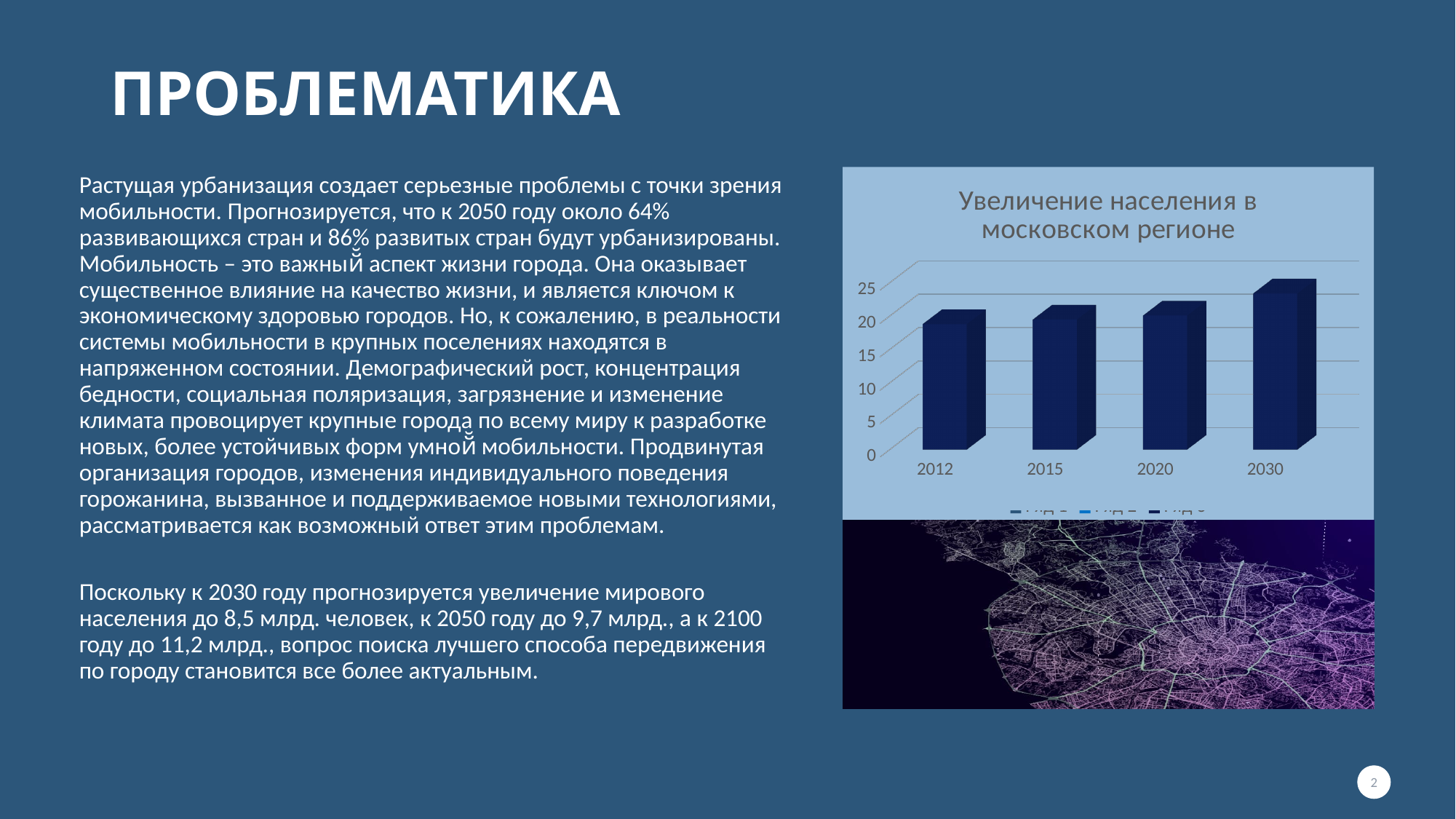
Do the values generally rise or fall from 2012 to 2030? rise How many categories (years) are shown on the x axis of the chart? 4 Is the value for 2030 greater or less than 20? greater Which year has the highest bar in the chart? 2030 Is the value for 2020 greater or less than 25? less What kind of chart is shown on the slide? bar chart What is the title of the chart? Увеличение населения в московском регионе Is the value for 2012 greater or less than 15? greater What is the highest tick value shown on the vertical axis of the chart? 25 Which is larger, the value for 2012 or the value for 2030? 2030